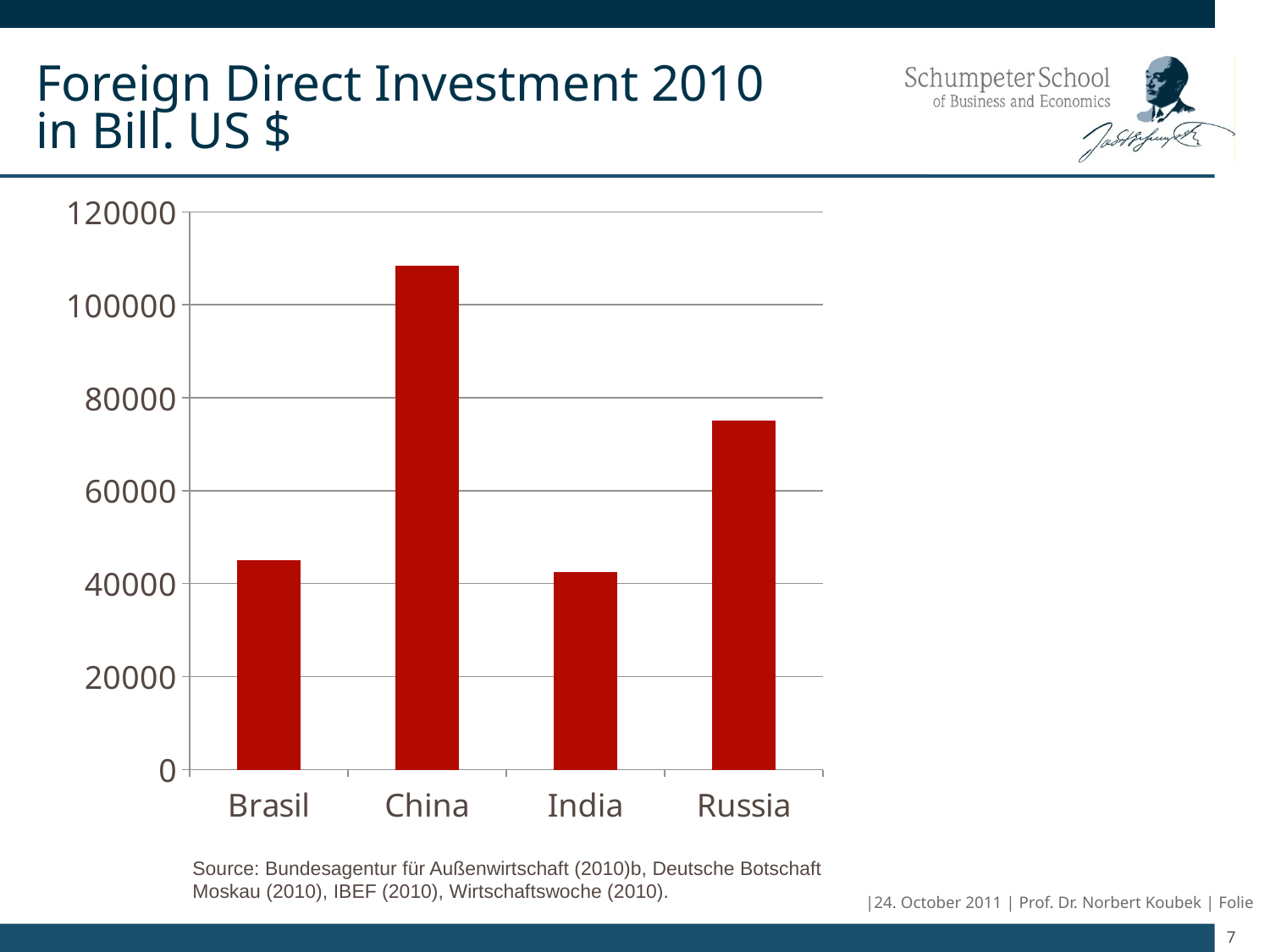
Is the value for Russia greater or less than 60000? greater What is the title of the slide containing the chart? Foreign Direct Investment 2010 in Bill. US $ How many countries are shown on the chart? 4 Is the value for Russia greater or less than 80000? less Which is larger, the value for Russia or the value for India? Russia Which country has the highest foreign direct investment in the chart? China Which is larger, the value for China or the value for Russia? China Is the value for China greater or less than 100000? greater What colour are the bars in the chart? red What kind of chart is shown on the slide? bar chart